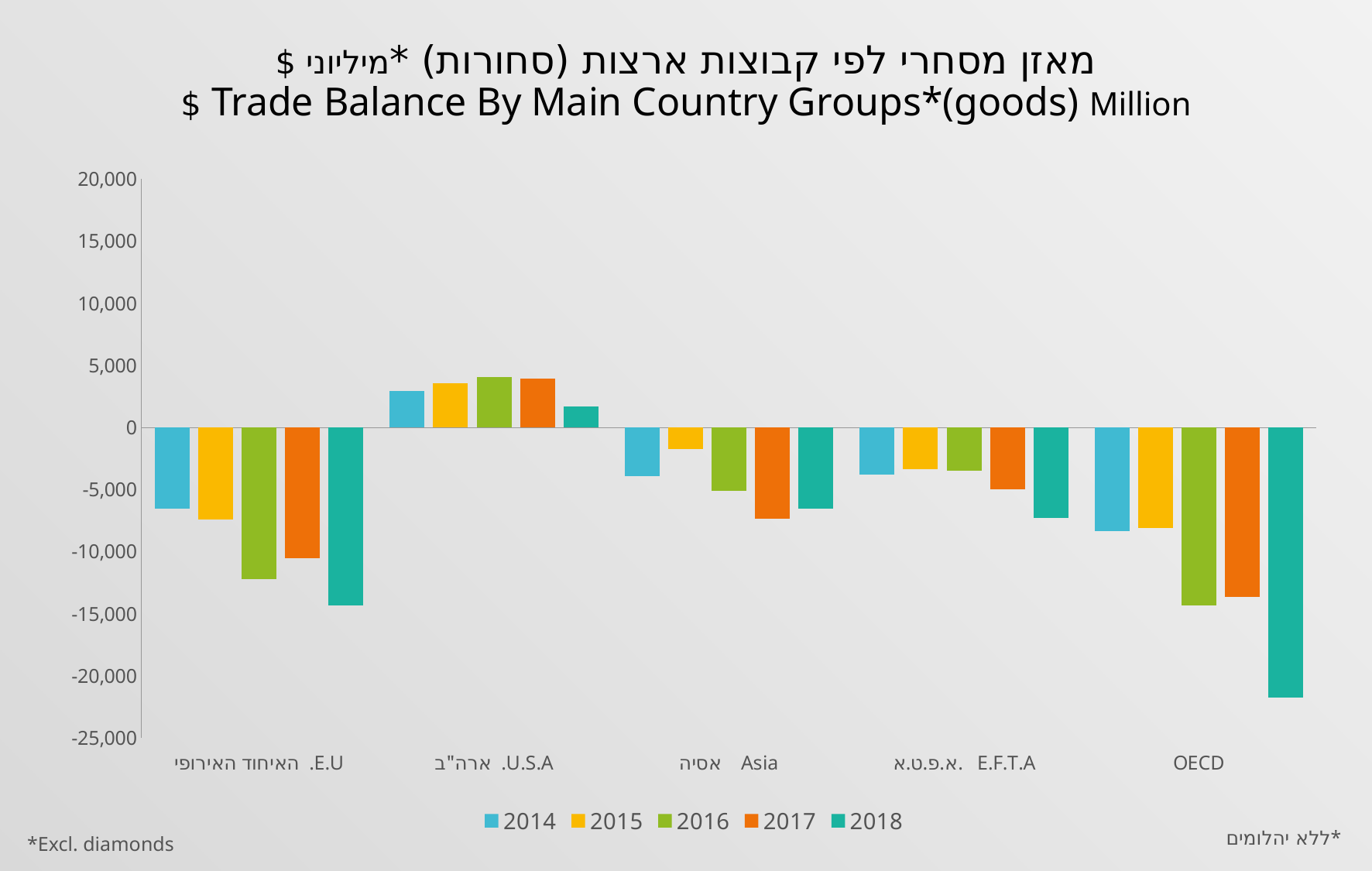
Is the value for Asia in 2015 greater or less than -5,000? greater How many series (years) does the legend list? 5 How many country groups are shown on the x axis? 5 Is the value for U.S.A in 2016 greater or less than 5,000? less What kind of chart is shown on the slide? bar chart Which country group has the lowest trade balance in 2018? OECD For OECD, which year has the lower trade balance, 2014 or 2018? 2018 Which country group has the highest trade balance in 2017? U.S.A Is the value for OECD in 2018 greater or less than -20,000? less Which country group has a positive trade balance in every year shown? U.S.A For the E.U, which year has the lower trade balance, 2016 or 2017? 2016